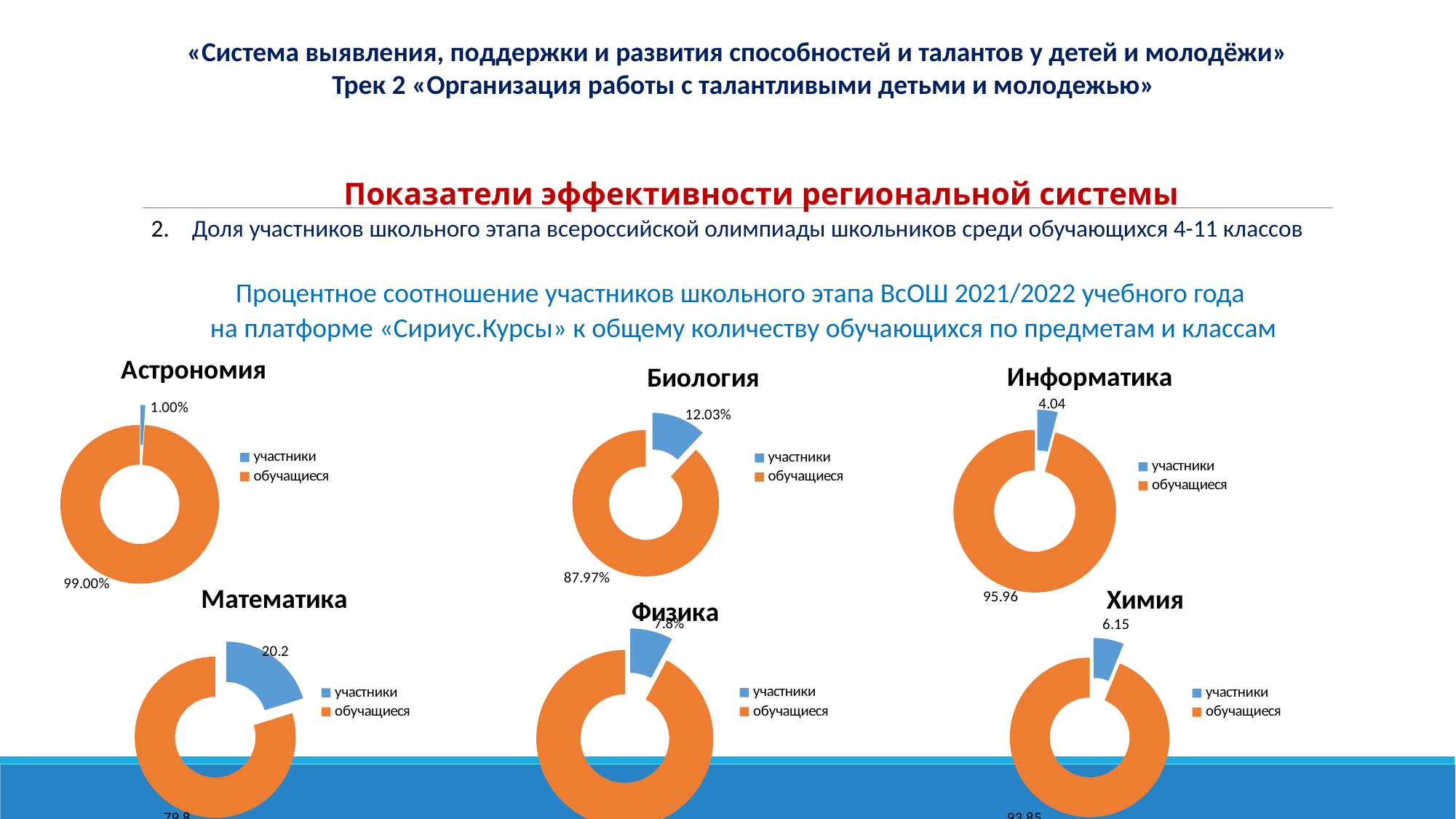
What kind of chart is used for each subject on the slide? Doughnut chart Which chart has the larger участники value, Биология or Информатика? Биология In the Физика chart, what is the value shown for участники? 7.8% In the Информатика chart, what is the value shown for обучащиеся? 95.96 In the Астрономия chart, what is the value shown for обучащиеся? 99.00% How many series does the legend of the Биология chart list? 2 In the Биология chart, what is the value shown for обучащиеся? 87.97% In the Астрономия chart, what is the value shown for участники? 1.00% In the Биология chart, what is the value shown for участники? 12.03% In the Математика chart, what is the value shown for участники? 20.2 In the Информатика chart, what is the value shown for участники? 4.04 In the Химия chart, what is the value shown for участники? 6.15